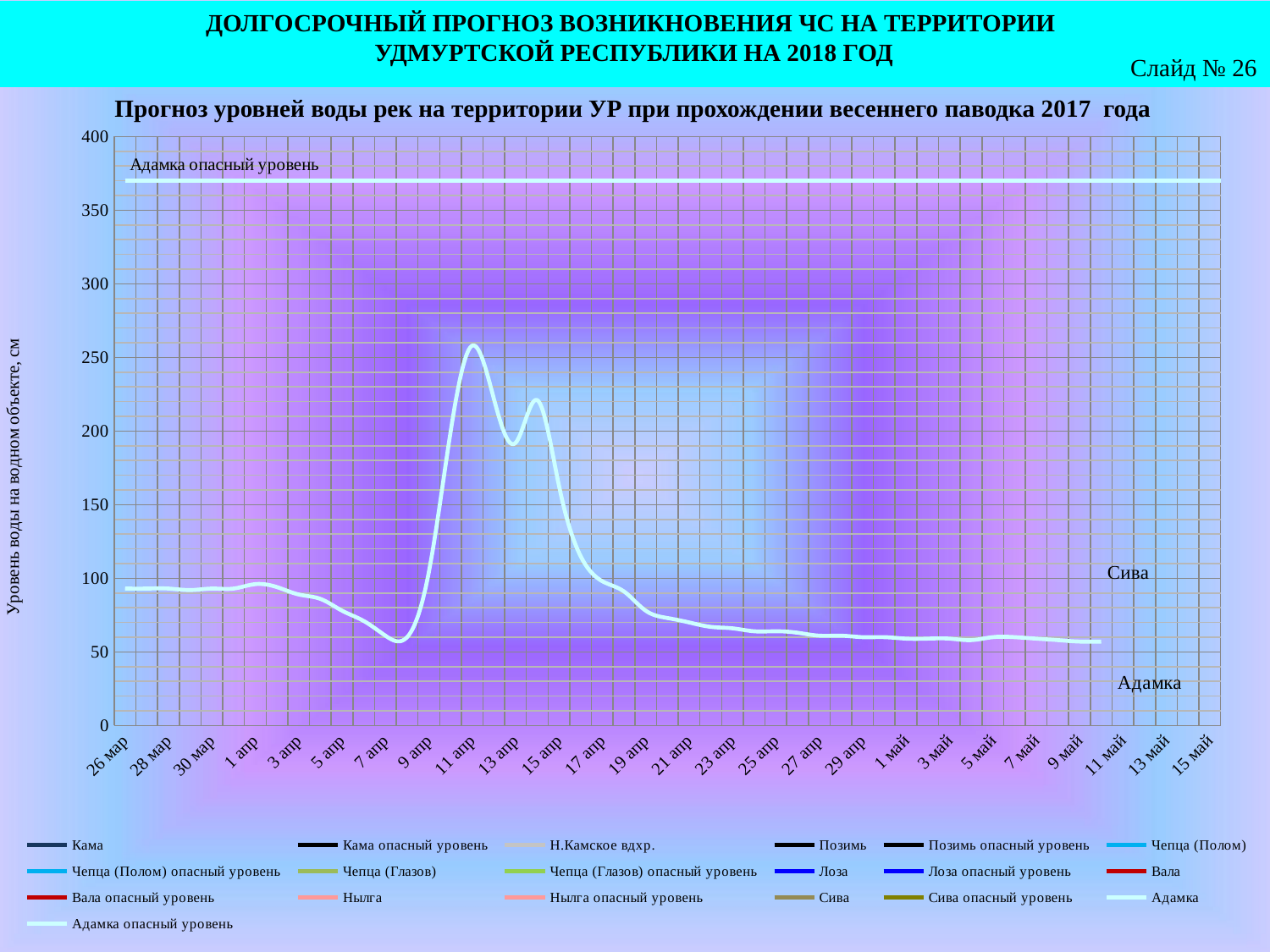
Is the value of the Адамка line on 7 апр greater or less than 100? less Is the peak value of the Адамка line around 11 апр greater or less than 200? greater What is the label of the vertical axis? Уровень воды на водном объекте, см How many series does the legend list? 19 Which is higher: the Адамка опасный уровень line or the peak of the Адамка line? Адамка опасный уровень What is the title of the chart? Прогноз уровней воды рек на территории УР при прохождении весеннего паводка 2017 года Is the value of the Адамка line on 9 май greater or less than 100? less Which is higher for the Адамка line: the value on 11 апр or the value on 15 апр? 11 апр How many date labels are shown on the x axis? 26 What kind of chart is shown on the slide? line chart Does the Адамка line rise or fall from 11 апр to 9 май? fall